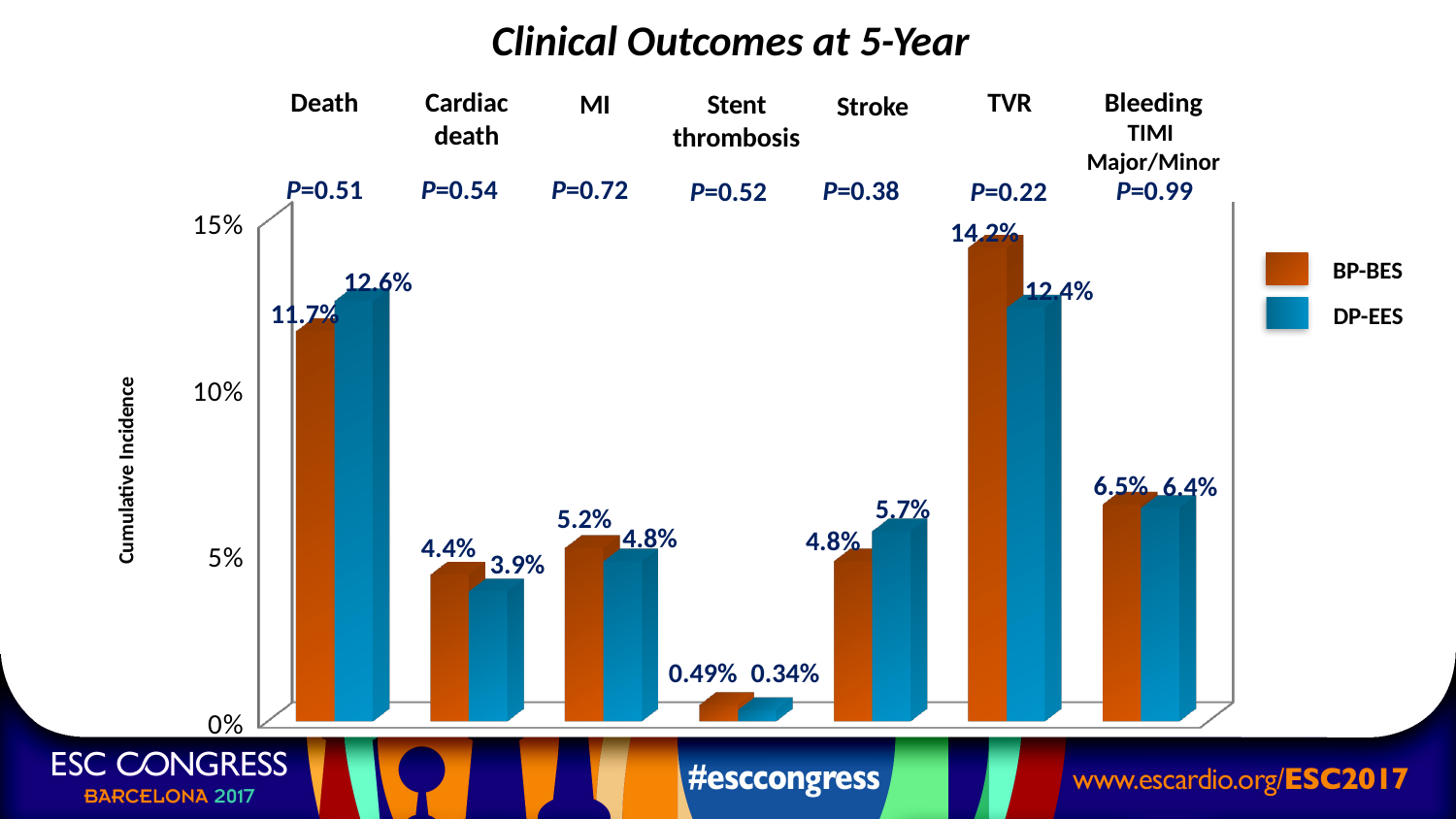
Which category has the highest value for BP-BES? TVR What kind of chart is shown on the slide? Bar chart What is the value for DP-EES in the Stent thrombosis category? 0.34% In the Cardiac death category, which series has the larger value, BP-BES or DP-EES? BP-BES How many outcome categories are shown on the chart? 7 Which category has the lowest value for DP-EES? Stent thrombosis What is the P value shown for the Bleeding TIMI Major/Minor category? P=0.99 What is the value for BP-BES in the Death category? 11.7% What is the value for DP-EES in the Stroke category? 5.7% How many series does the legend list? 2 What is the difference between the BP-BES and DP-EES values in the TVR category? 1.8% What is the value for BP-BES in the TVR category? 14.2%